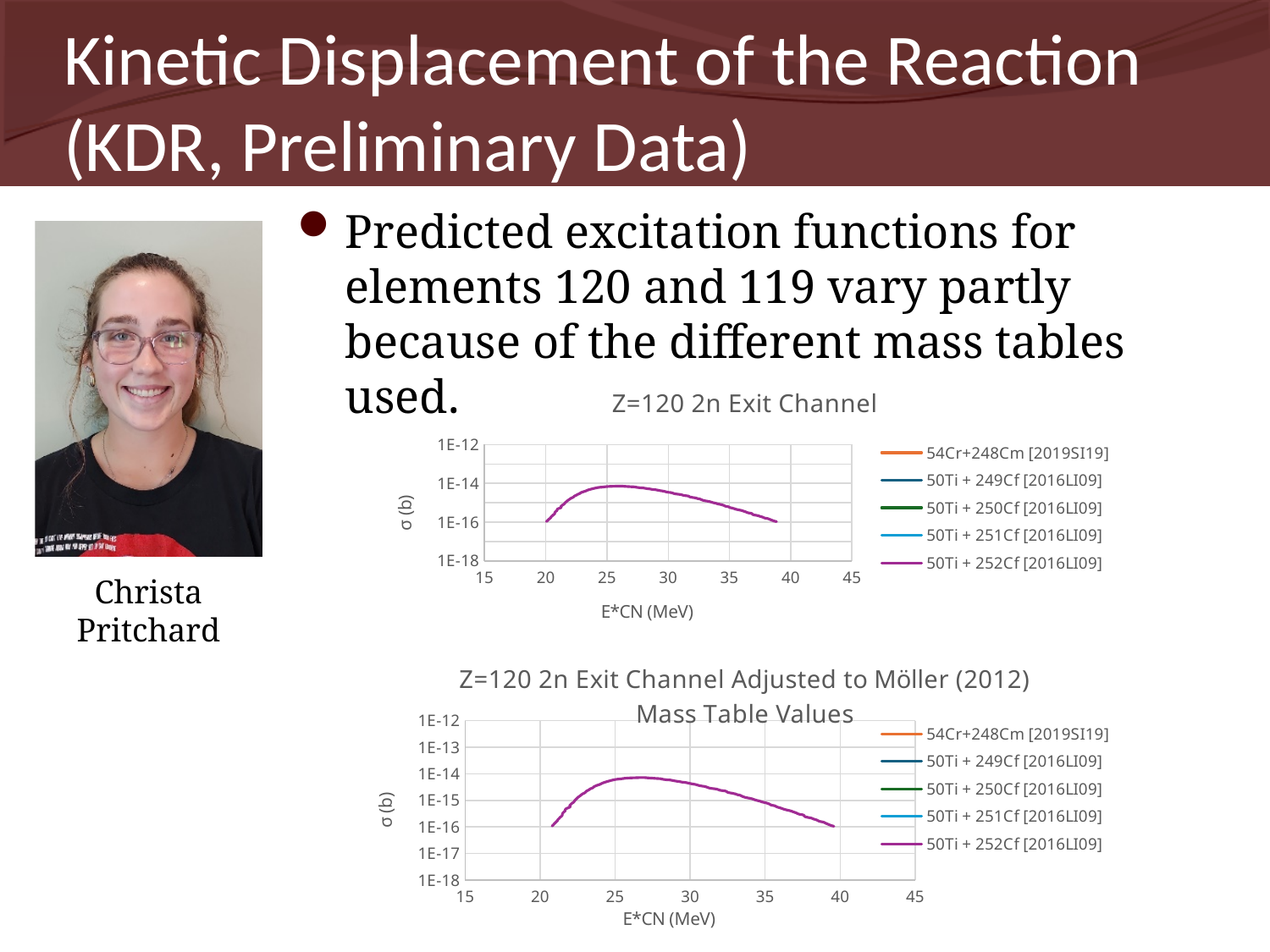
What kind of chart is the top chart titled "Z=120 2n Exit Channel"? Line chart In the top chart "Z=120 2n Exit Channel", which legend entry is shown in magenta? 50Ti + 252Cf [2016LI09] In the top chart "Z=120 2n Exit Channel", is the cross section at 25 MeV larger or smaller than at 35 MeV? larger How many series does the legend of the top chart "Z=120 2n Exit Channel" list? 5 In the bottom chart "Z=120 2n Exit Channel Adjusted to Möller (2012) Mass Table Values", does the curve rise or fall as E*CN increases from 21 MeV to 25 MeV? rise In the top chart "Z=120 2n Exit Channel", does the curve rise or fall as E*CN increases from 30 MeV to 38 MeV? fall In the bottom chart "Z=120 2n Exit Channel Adjusted to Möller (2012) Mass Table Values", is the peak value of the plotted curve greater or less than 1E-15? greater In the bottom chart "Z=120 2n Exit Channel Adjusted to Möller (2012) Mass Table Values", is the peak value of the plotted curve greater or less than 1E-13? less How many series does the legend of the bottom chart "Z=120 2n Exit Channel Adjusted to Möller (2012) Mass Table Values" list? 5 In the top chart "Z=120 2n Exit Channel", is the peak value of the plotted curve greater or less than 1E-16? greater What is the x-axis label of the bottom chart "Z=120 2n Exit Channel Adjusted to Möller (2012) Mass Table Values"? E*CN (MeV)